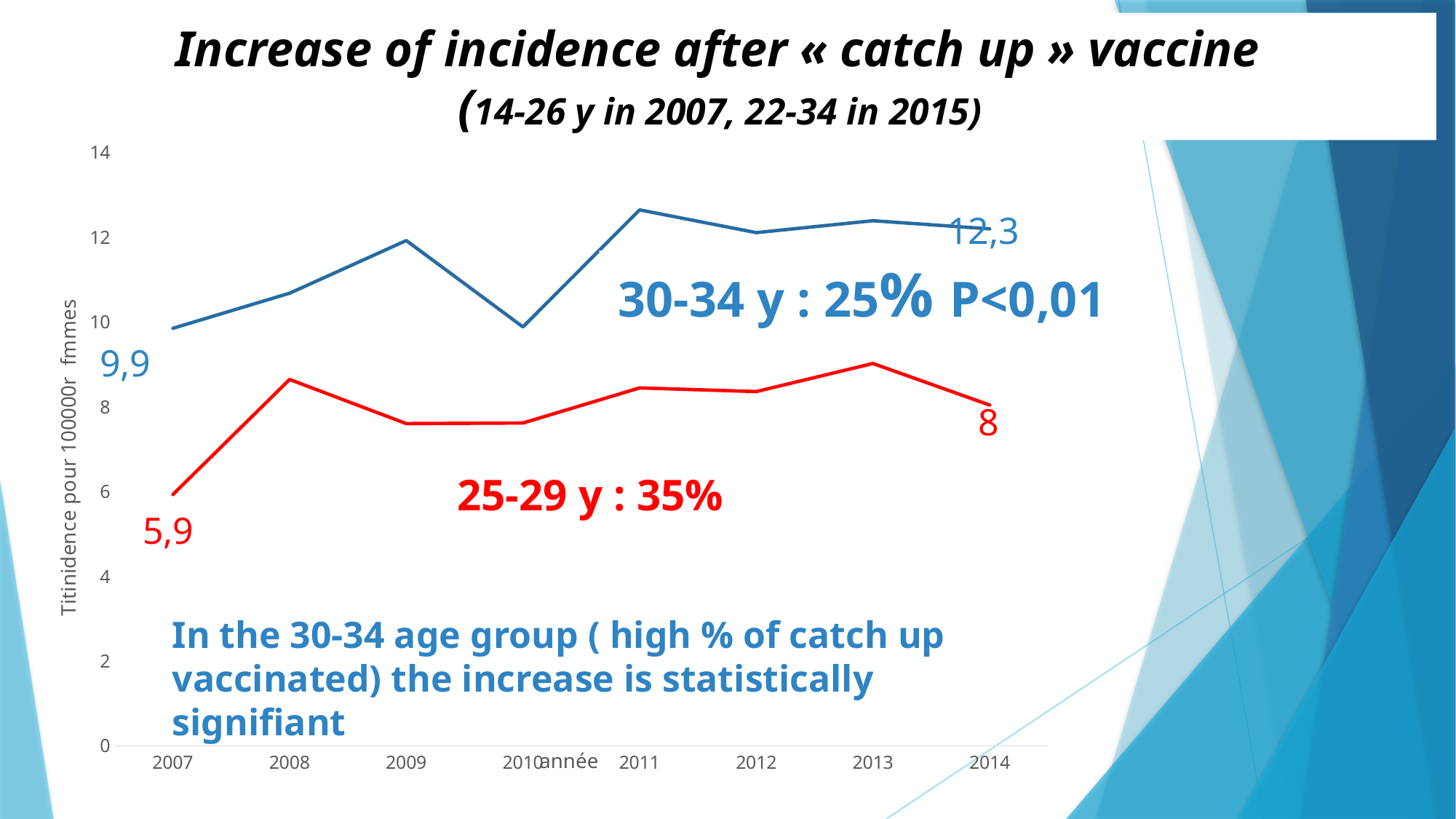
What kind of chart is shown on the slide? line chart What colour is the line for the 30-34 y age group? blue What is the difference between the blue (30-34 y) and red (25-29 y) values in 2007? 4 How many years are plotted along the x axis? 8 In which year does the red (25-29 y) line reach its lowest value? 2007 By how much did the blue (30-34 y) line increase from 2007 to 2014? 2,4 What is the value of the blue (30-34 y) line in 2014? 12,3 What is the value of the blue (30-34 y) line in 2007? 9,9 In 2014, which line has the higher value, the blue (30-34 y) or the red (25-29 y)? blue (30-34 y) What is the value of the red (25-29 y) line in 2014? 8 Is the value of the red (25-29 y) line in 2008 greater or less than 8? greater What is the value of the red (25-29 y) line in 2007? 5,9